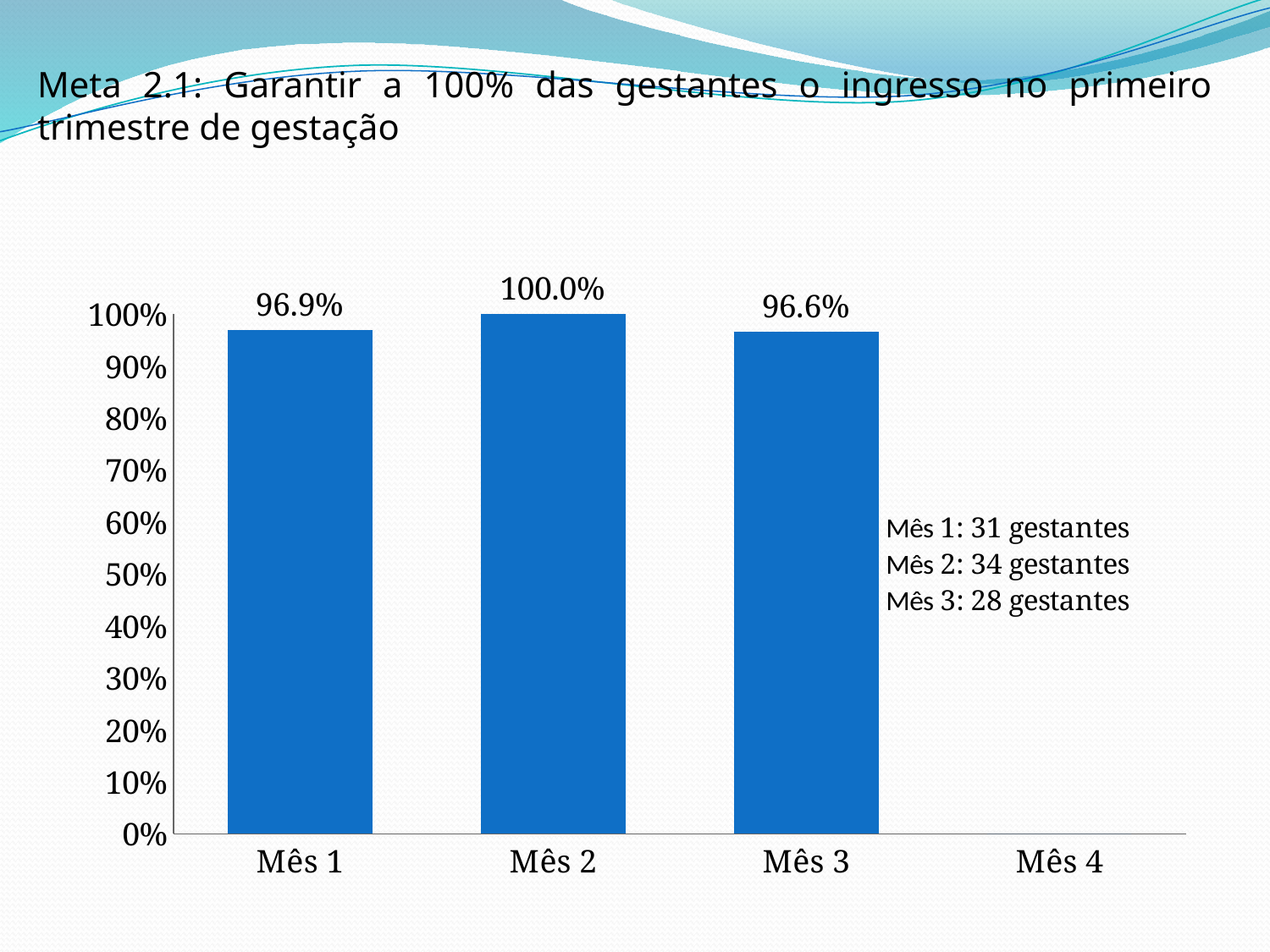
How many categories are shown on the x axis? 4 Among the months with a bar, which has the lowest value? Mês 3 What is the value for Mês 2? 100.0% What is the value for Mês 1? 96.9% Which month has the highest value? Mês 2 Is the value for Mês 3 greater or less than 90%? greater Which is larger, the value for Mês 1 or the value for Mês 3? Mês 1 What is the value for Mês 3? 96.6% What kind of chart is shown on the slide? bar chart What is the difference between the values for Mês 2 and Mês 1? 3.1% According to the note on the chart, how many gestantes were there in Mês 2? 34 gestantes How many bars are plotted in the chart? 3